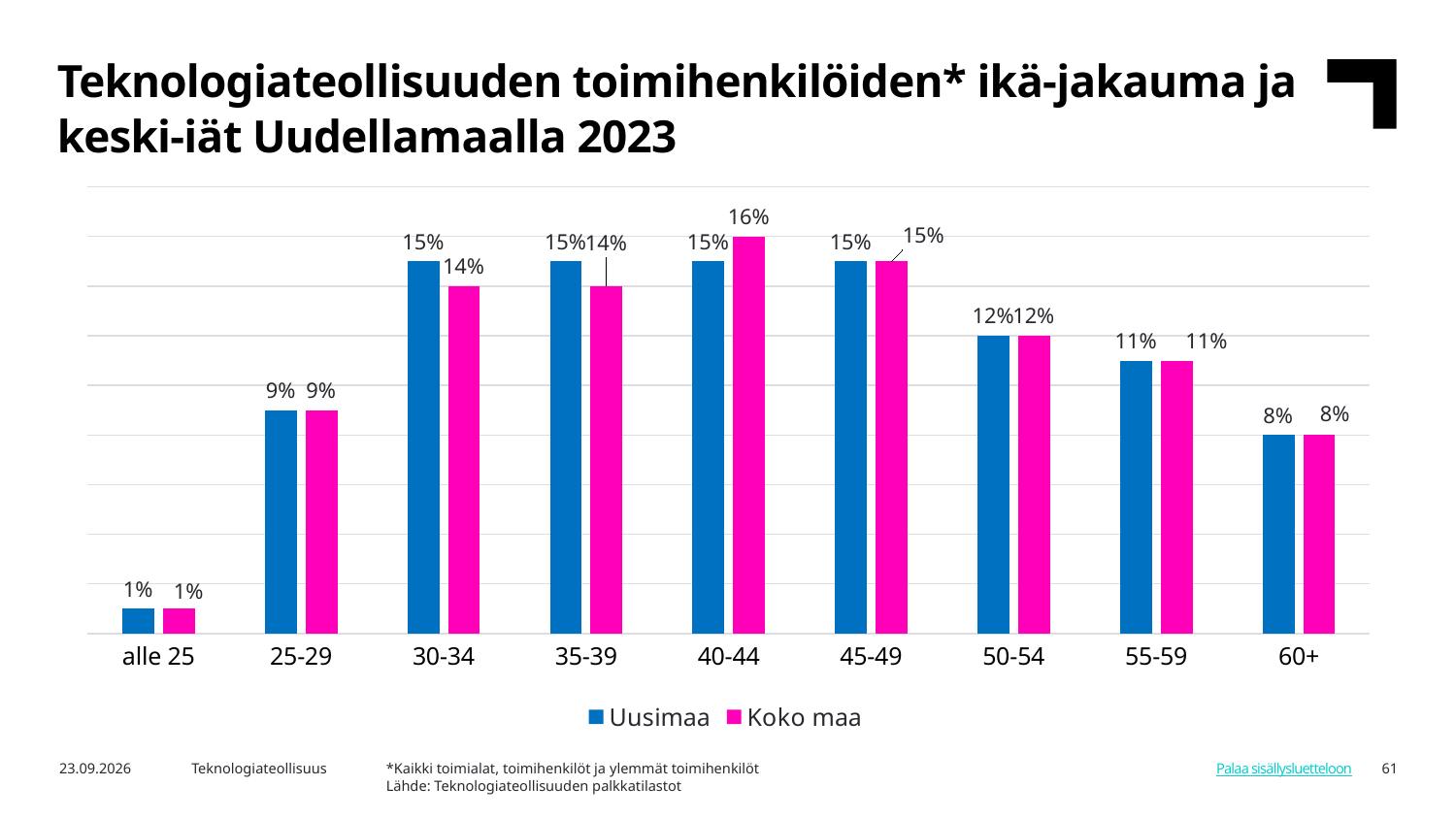
What is the Uusimaa value for the 60+ age group? 8% What is the Koko maa value for the 40-44 age group? 16% How many series does the legend list? 2 For the 40-44 age group, which series has the larger value, Uusimaa or Koko maa? Koko maa Which age group has the lowest Uusimaa value? alle 25 What is the Koko maa value for the 30-34 age group? 14% Which age group has the highest Koko maa value? 40-44 Which colour represents the Koko maa series in the chart? Pink How many age categories are shown on the x axis? 9 What is the difference between the Uusimaa and Koko maa values for the 35-39 age group? 1 percentage point What is the Uusimaa value for the 50-54 age group? 12% What kind of chart is shown on the slide? Bar chart